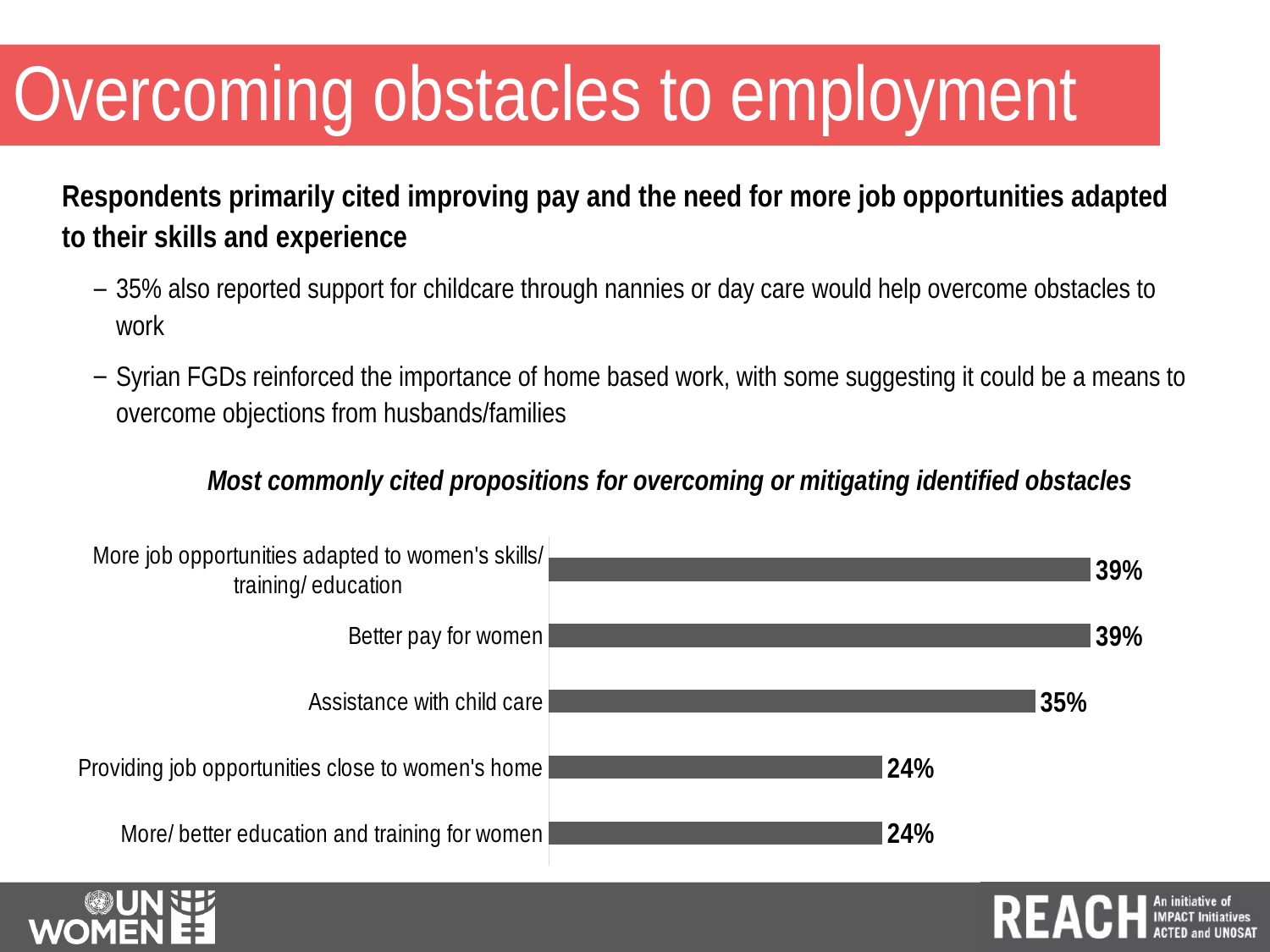
What kind of chart is shown on the slide? Bar chart What is the value for "More job opportunities adapted to women's skills/ training/ education"? 39% What is the difference between the value for "Assistance with child care" and the value for "More/ better education and training for women"? 11% What is the title of the chart? Most commonly cited propositions for overcoming or mitigating identified obstacles Which category has the lowest value, "Assistance with child care" or "More/ better education and training for women"? More/ better education and training for women What is the value for "Better pay for women"? 39% What is the value for "Providing job opportunities close to women's home"? 24% How many categories are shown in the chart? 5 Which is larger, the value for "Assistance with child care" or the value for "Providing job opportunities close to women's home"? Assistance with child care What is the difference between the value for "Better pay for women" and the value for "Assistance with child care"? 4% What is the value for "Assistance with child care"? 35% What is the value for "More/ better education and training for women"? 24%